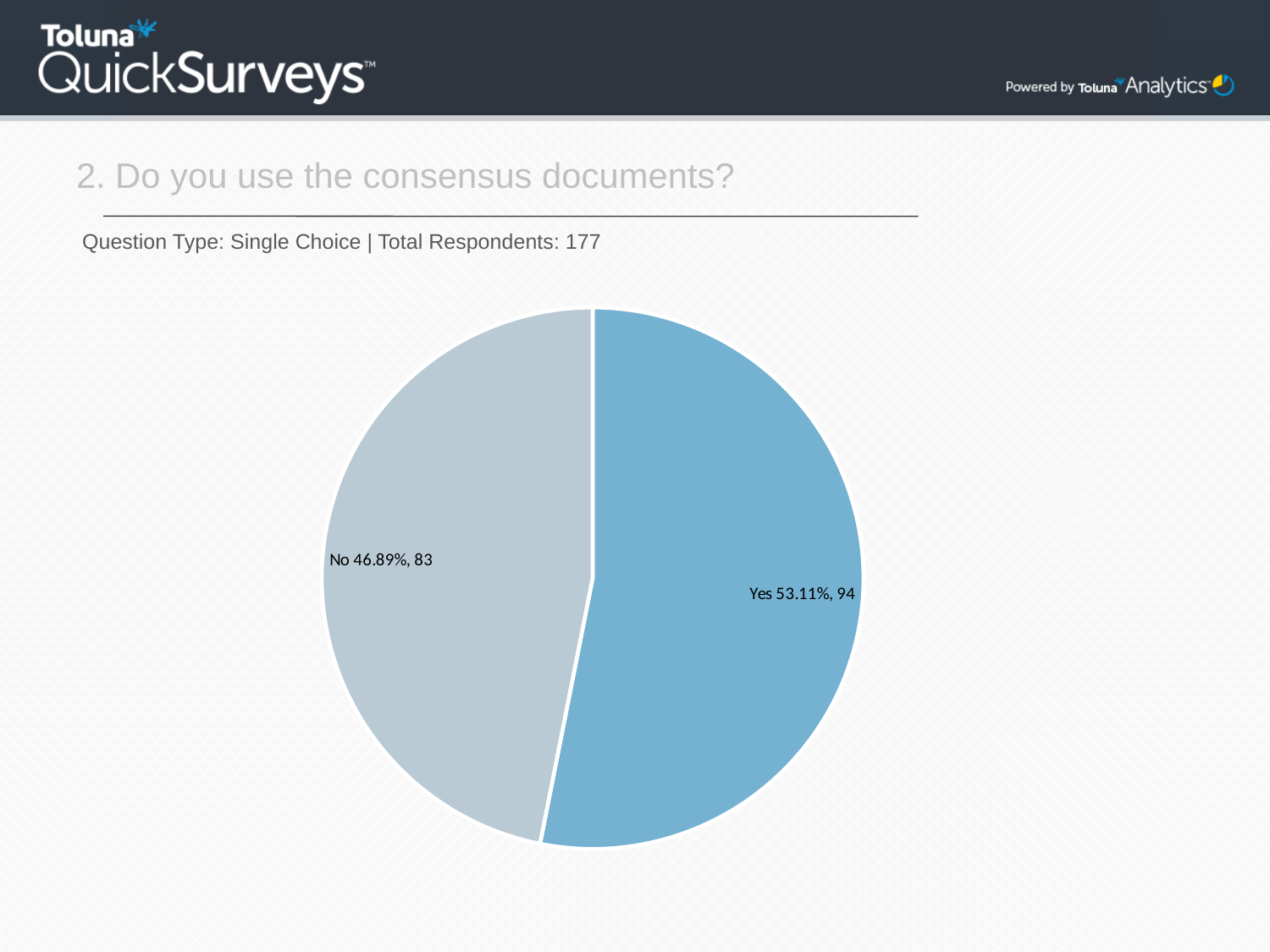
How many slices does the pie chart have? 2 How many more respondents answered Yes than No? 11 How many respondents answered Yes? 94 What kind of chart is shown on the slide? pie chart What is the question title shown above the chart? 2. Do you use the consensus documents? Which response has the smaller share of the pie? No What percentage of respondents answered Yes? 53.11% Which response has the larger share of the pie? Yes How many respondents answered No? 83 What is the difference in percentage points between the Yes and No slices? 6.22 What percentage of respondents answered No? 46.89% What is the total number of respondents shown on the slide? 177